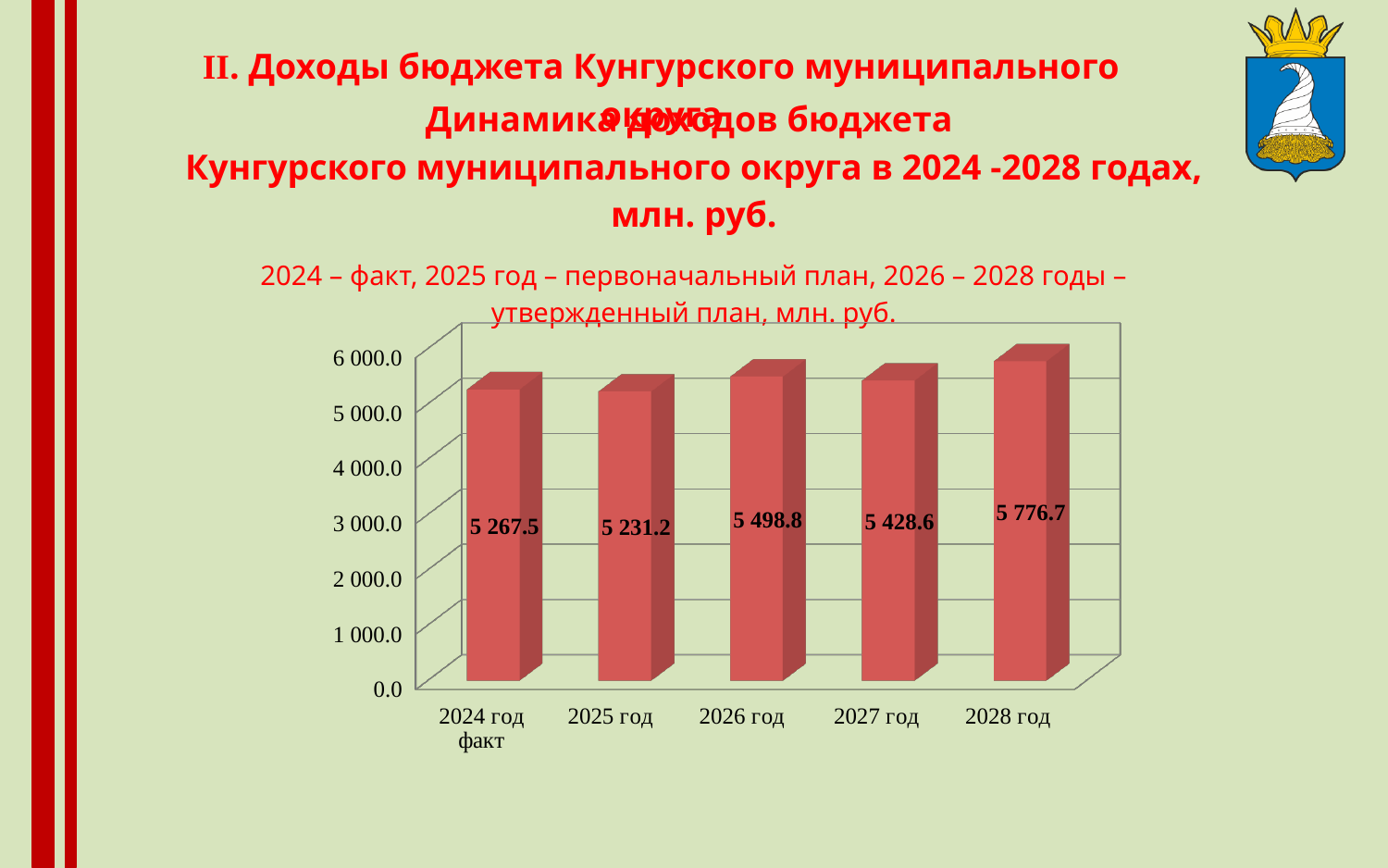
What is the difference between the values for 2026 год and 2025 год? 267.6 Which year has the lowest value? 2025 год What kind of chart is shown on the slide? bar chart What is the value for 2026 год? 5 498.8 What is the value for 2024 год факт? 5 267.5 Is the value for 2025 год greater or less than 5 000.0? greater What is the difference between the values for 2028 год and 2024 год факт? 509.2 What is the value for 2028 год? 5 776.7 How many years are shown on the chart? 5 Which is larger, the value for 2026 год or 2027 год? 2026 год What colour are the bars in the chart? red Which year has the highest value? 2028 год